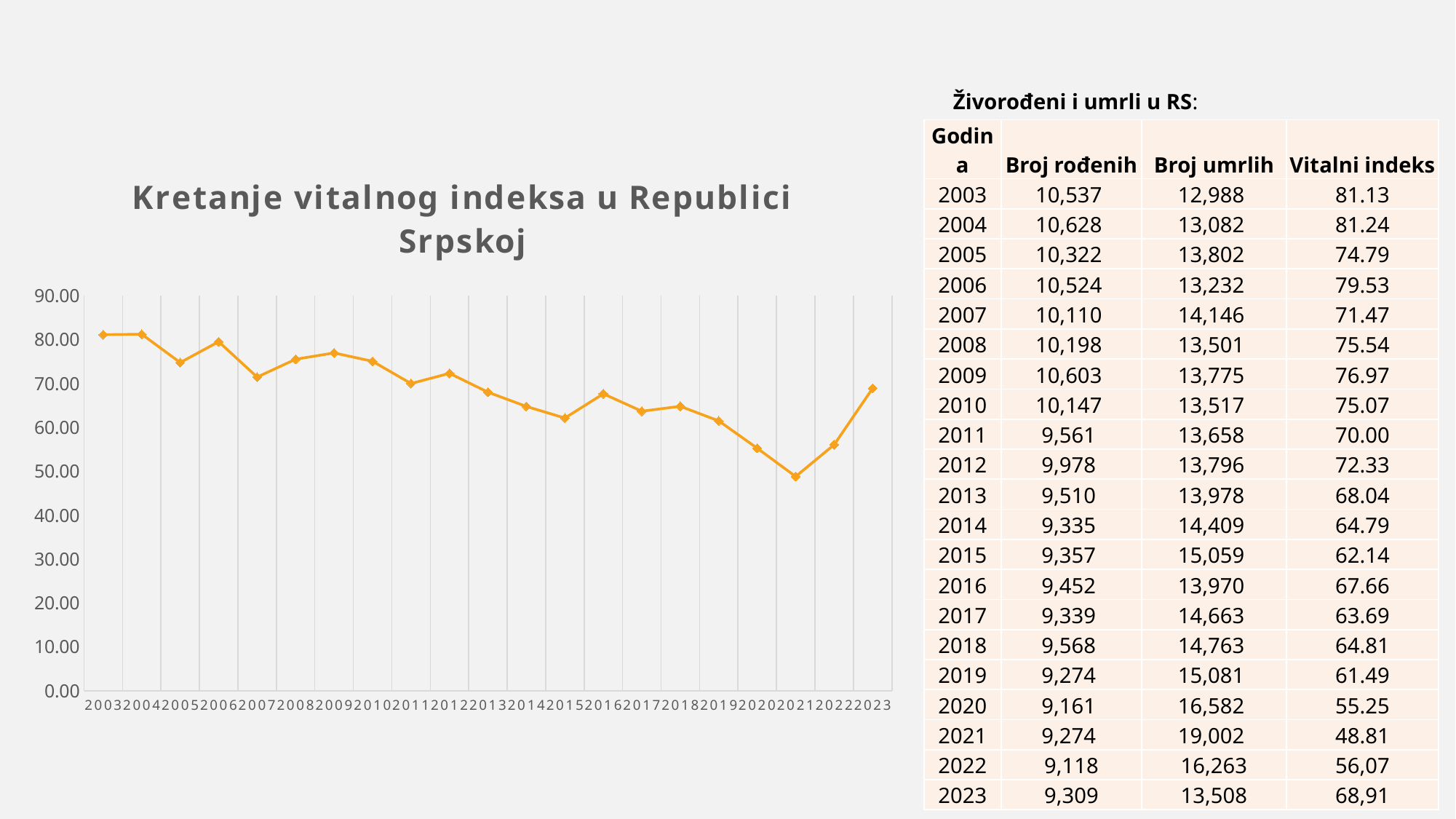
Is the value for 2003 on the chart greater or less than 80? greater Does the line on the chart generally rise or fall from 2003 to 2021? fall Is the value for 2020 on the chart greater or less than 60? less Which year has the lowest value on the chart? 2021 Is the value for 2021 on the chart greater or less than 50? less How many years are plotted on the x axis of the chart? 21 Which year has the larger value on the chart, 2005 or 2006? 2006 What is the title of the chart? Kretanje vitalnog indeksa u Republici Srpskoj Which year has the larger value on the chart, 2022 or 2023? 2023 According to the table, what is the Vitalni indeks value for 2021? 48.81 What kind of chart is shown on the slide? line chart